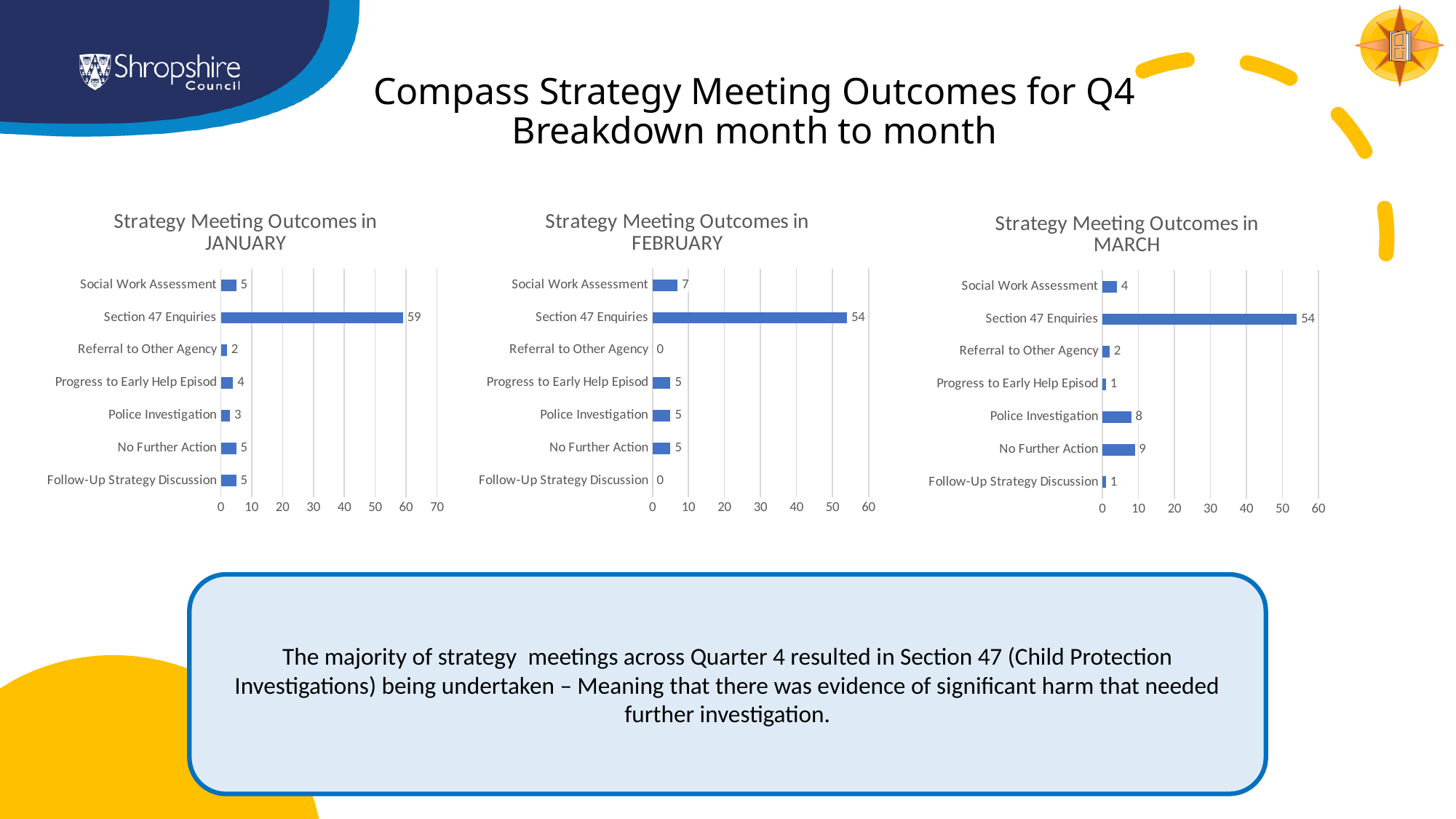
In the 'Strategy Meeting Outcomes in FEBRUARY' chart, what is the difference between Section 47 Enquiries and Social Work Assessment? 47 What kind of chart is the 'Strategy Meeting Outcomes in MARCH' chart? Bar chart How many charts are shown on the slide? 3 In the 'Strategy Meeting Outcomes in FEBRUARY' chart, what is the value for Social Work Assessment? 7 In the 'Strategy Meeting Outcomes in JANUARY' chart, what is the value for Section 47 Enquiries? 59 In the 'Strategy Meeting Outcomes in MARCH' chart, what is the value for No Further Action? 9 In the 'Strategy Meeting Outcomes in FEBRUARY' chart, which categories have a value of 0? Referral to Other Agency and Follow-Up Strategy Discussion How many categories are shown in the 'Strategy Meeting Outcomes in FEBRUARY' chart? 7 In the 'Strategy Meeting Outcomes in JANUARY' chart, which category has the lowest value? Referral to Other Agency In the 'Strategy Meeting Outcomes in MARCH' chart, which category has the highest value? Section 47 Enquiries In the 'Strategy Meeting Outcomes in JANUARY' chart, is the value for Section 47 Enquiries greater or less than 50? greater In the 'Strategy Meeting Outcomes in MARCH' chart, which is larger: Police Investigation or Social Work Assessment? Police Investigation